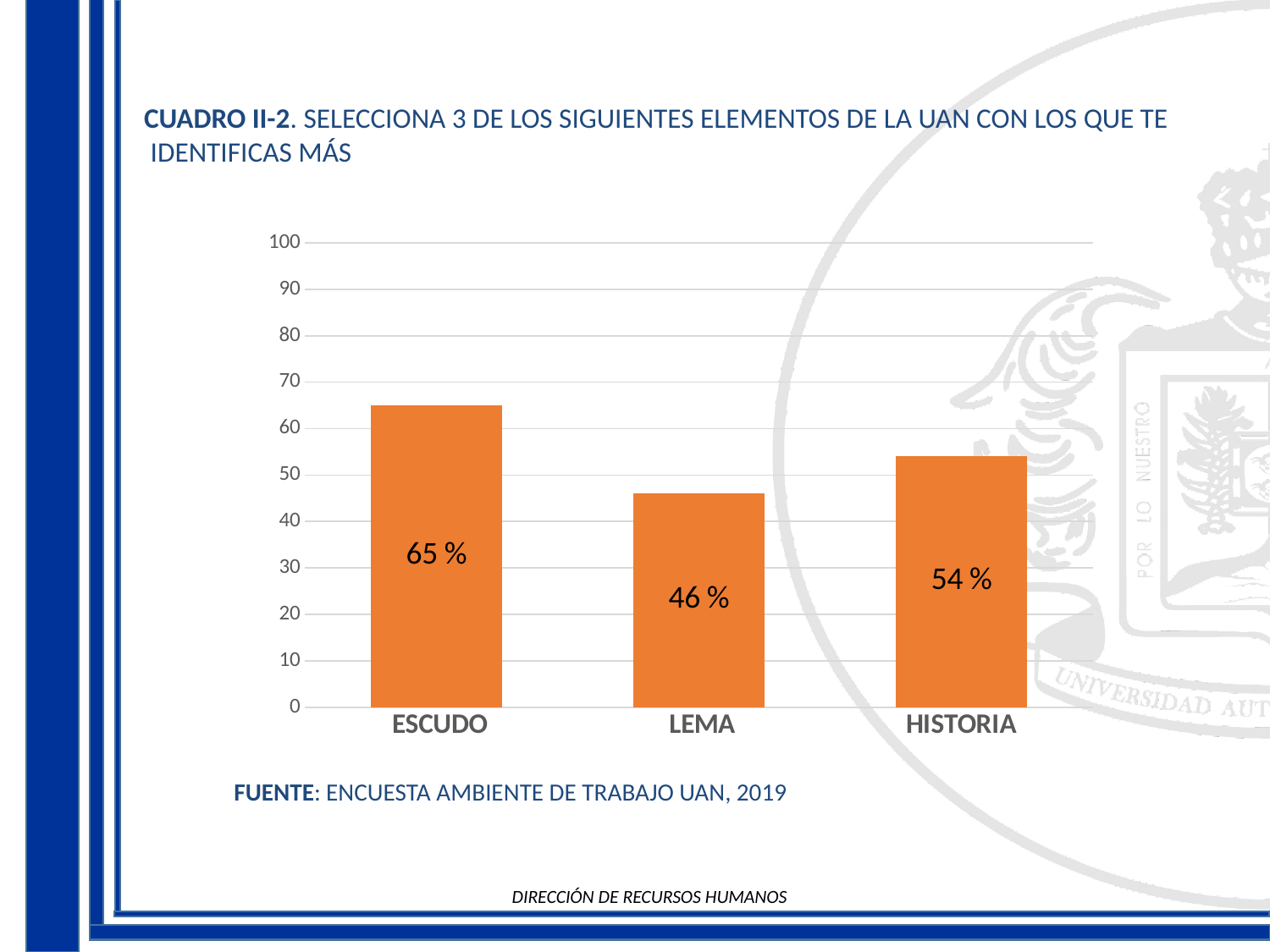
Is the value for ESCUDO greater or less than 60? greater What is the value for HISTORIA? 54 % What is the value for LEMA? 46 % Which category has the lowest value? LEMA What is the difference between the values for ESCUDO and LEMA? 19 % Which category has the highest value? ESCUDO What source is cited below the chart? ENCUESTA AMBIENTE DE TRABAJO UAN, 2019 What is the value for ESCUDO? 65 % How many categories are shown on the x axis? 3 What kind of chart is shown on the slide? bar chart Which is larger, the value for HISTORIA or the value for LEMA? HISTORIA What is the difference between the values for HISTORIA and LEMA? 8 %